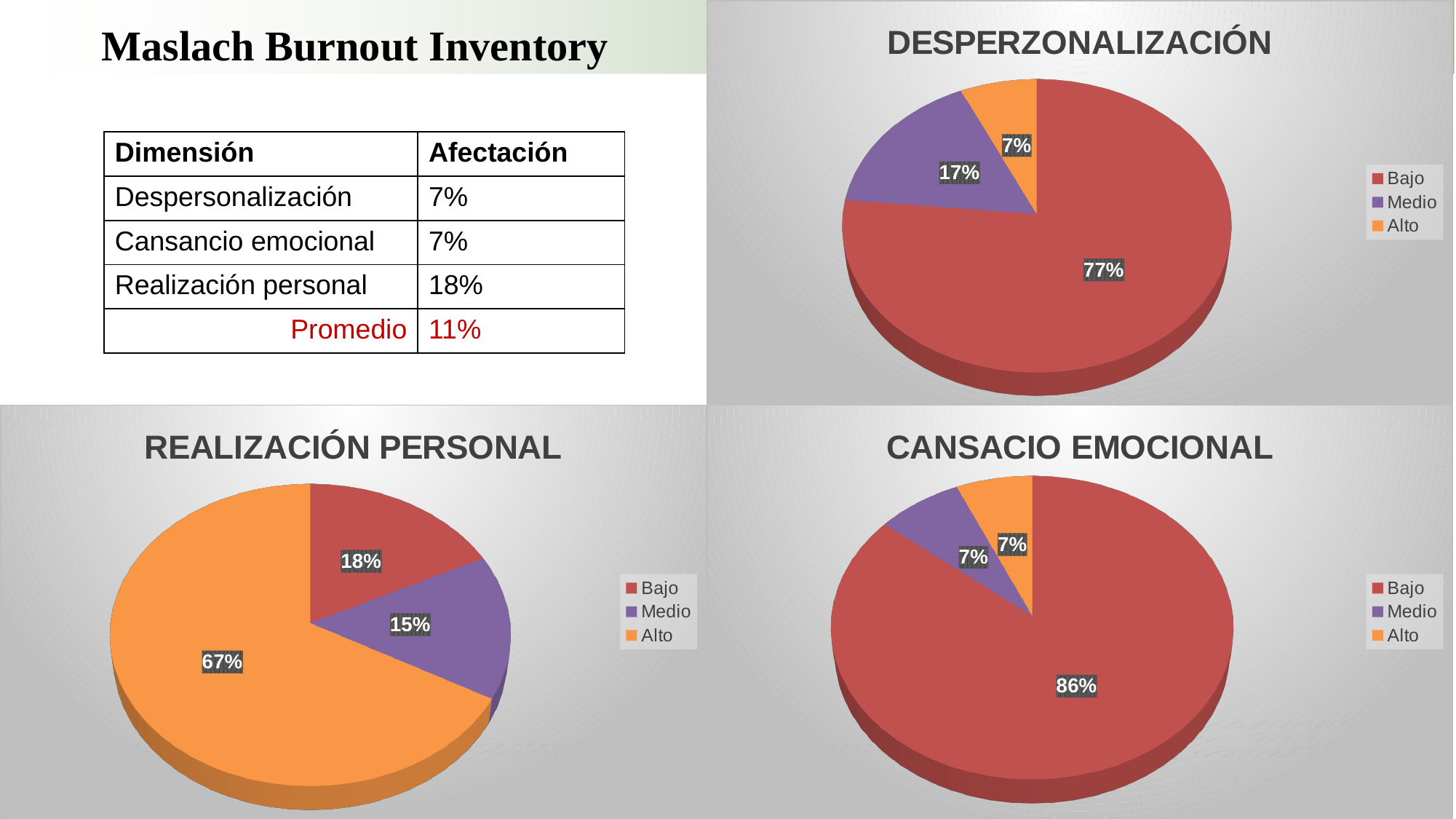
In the REALIZACIÓN PERSONAL chart, which category has the largest slice? Alto In the DESPERZONALIZACIÓN chart, what is the value for Medio? 17% In the DESPERZONALIZACIÓN chart, which is larger, Medio or Alto? Medio In the REALIZACIÓN PERSONAL chart, what is the difference between Bajo and Medio? 3% In the REALIZACIÓN PERSONAL chart, what is the value for Alto? 67% What kind of chart is the REALIZACIÓN PERSONAL chart? Pie chart In the CANSACIO EMOCIONAL chart, what share of the pie is Bajo? 86% In the DESPERZONALIZACIÓN chart, which category has the smallest slice? Alto How many categories does the legend of the CANSACIO EMOCIONAL chart list? 3 In the CANSACIO EMOCIONAL chart, what is the difference between Bajo and Alto? 79% In the REALIZACIÓN PERSONAL chart, which colour represents Alto? Orange In the DESPERZONALIZACIÓN chart, what share of the pie is Bajo? 77%